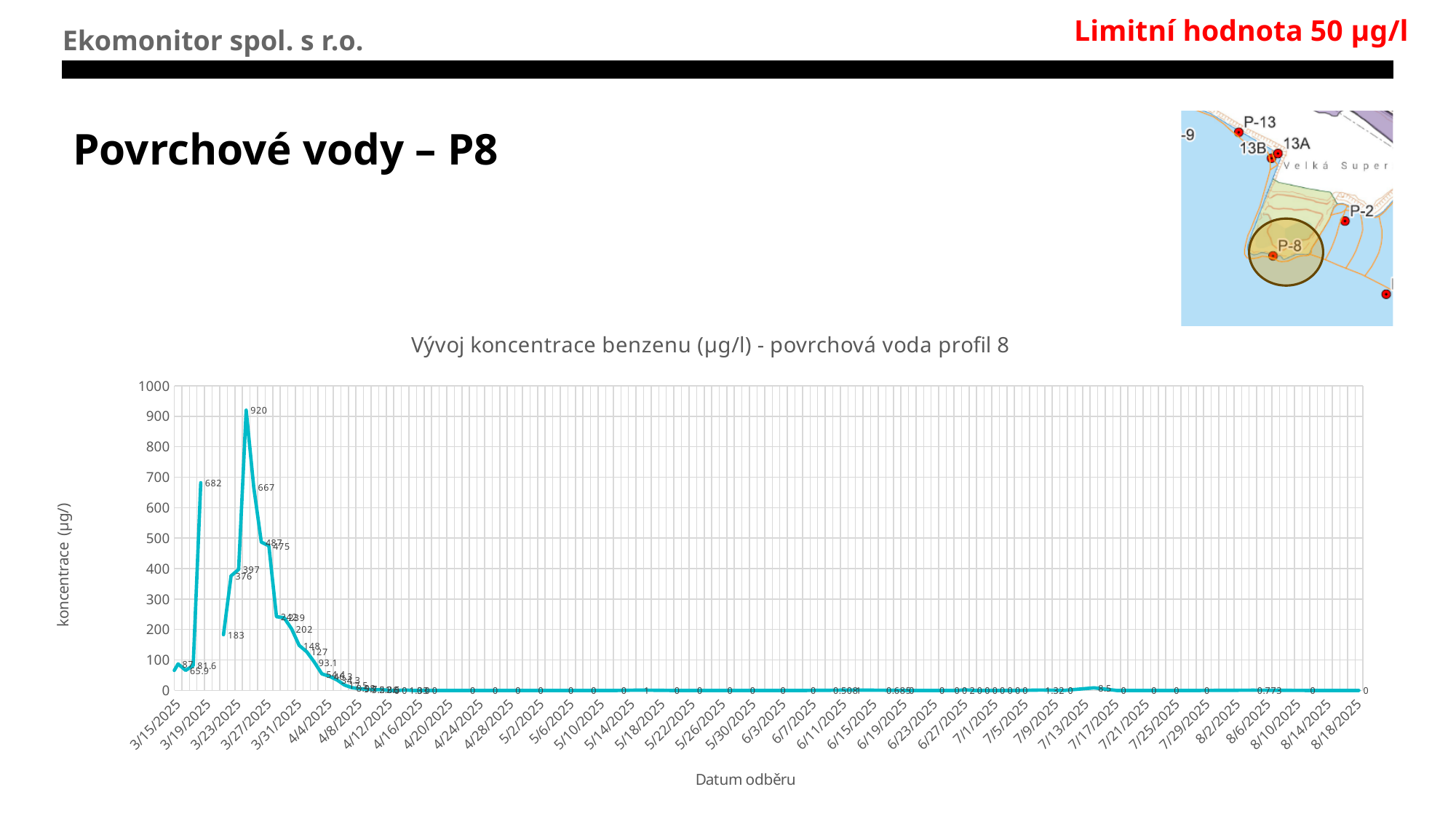
Is the highest point on the chart greater or less than 900? greater Do the concentration values rise or fall from late March 2025 to August 2025? fall What kind of chart is shown on the slide? line chart How many data series (lines) are plotted on the chart? 1 What is the difference between the values labeled 667 and 487? 180 What is the title of the chart? Vývoj koncentrace benzenu (µg/l) - povrchová voda profil 8 What is the maximum value shown on the vertical axis? 1000 What is the difference between the highest labeled value (920) and the earlier peak labeled 682? 238 Is the point labeled 183 greater or less than 200? less What is the highest benzene concentration value labeled on the chart? 920 What is the label on the vertical axis of the chart? koncentrace (µg/l) Which is larger: the peak labeled 920 or the peak labeled 682? 920